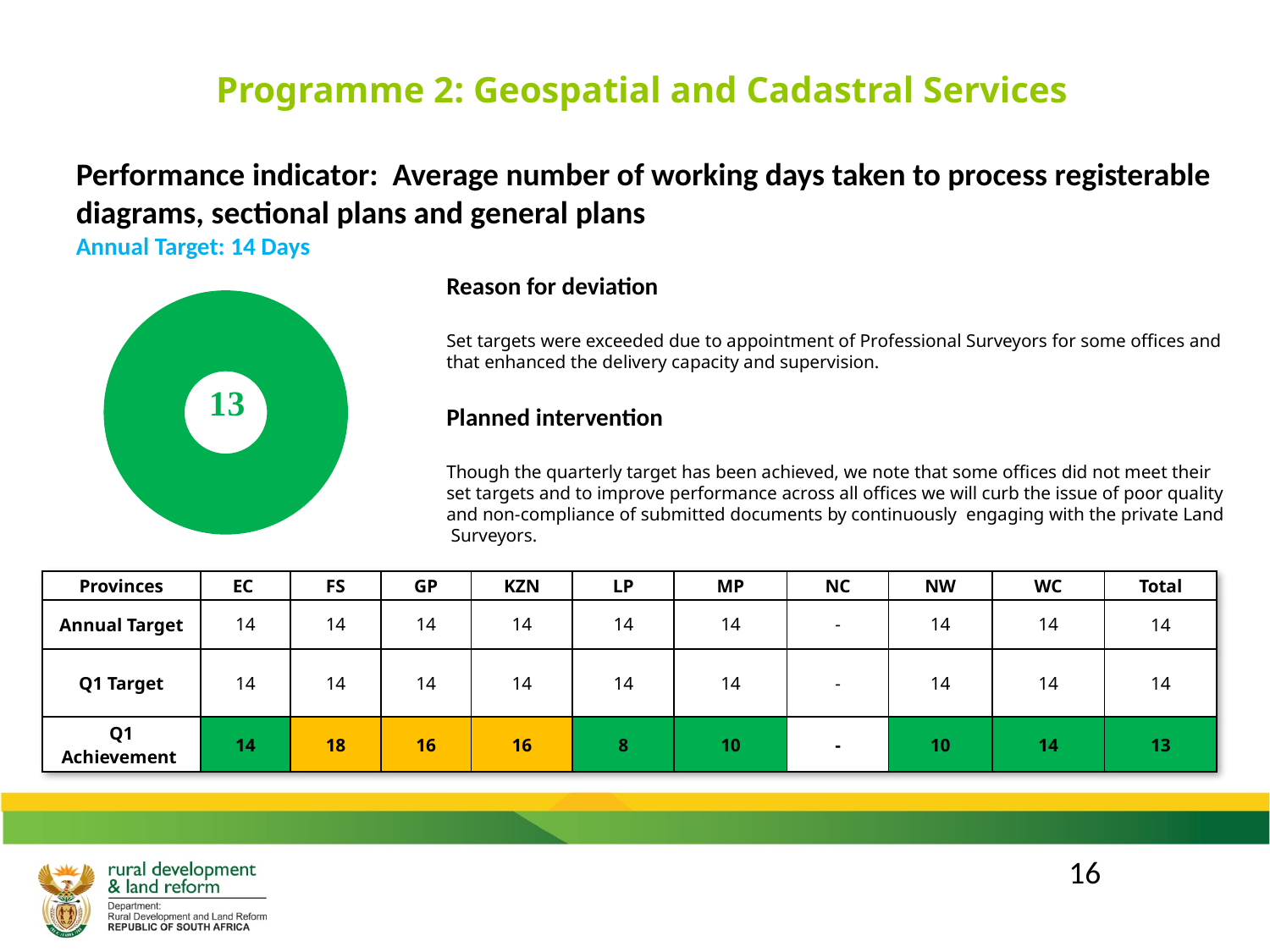
Is the value shown in the doughnut chart greater or less than the annual target of 14 days stated on the slide? less How many segments are visible in the doughnut chart? 1 What value is printed in the centre of the doughnut chart? 13 What colour is the ring of the doughnut chart? green What kind of chart is shown on the left of the slide? doughnut chart